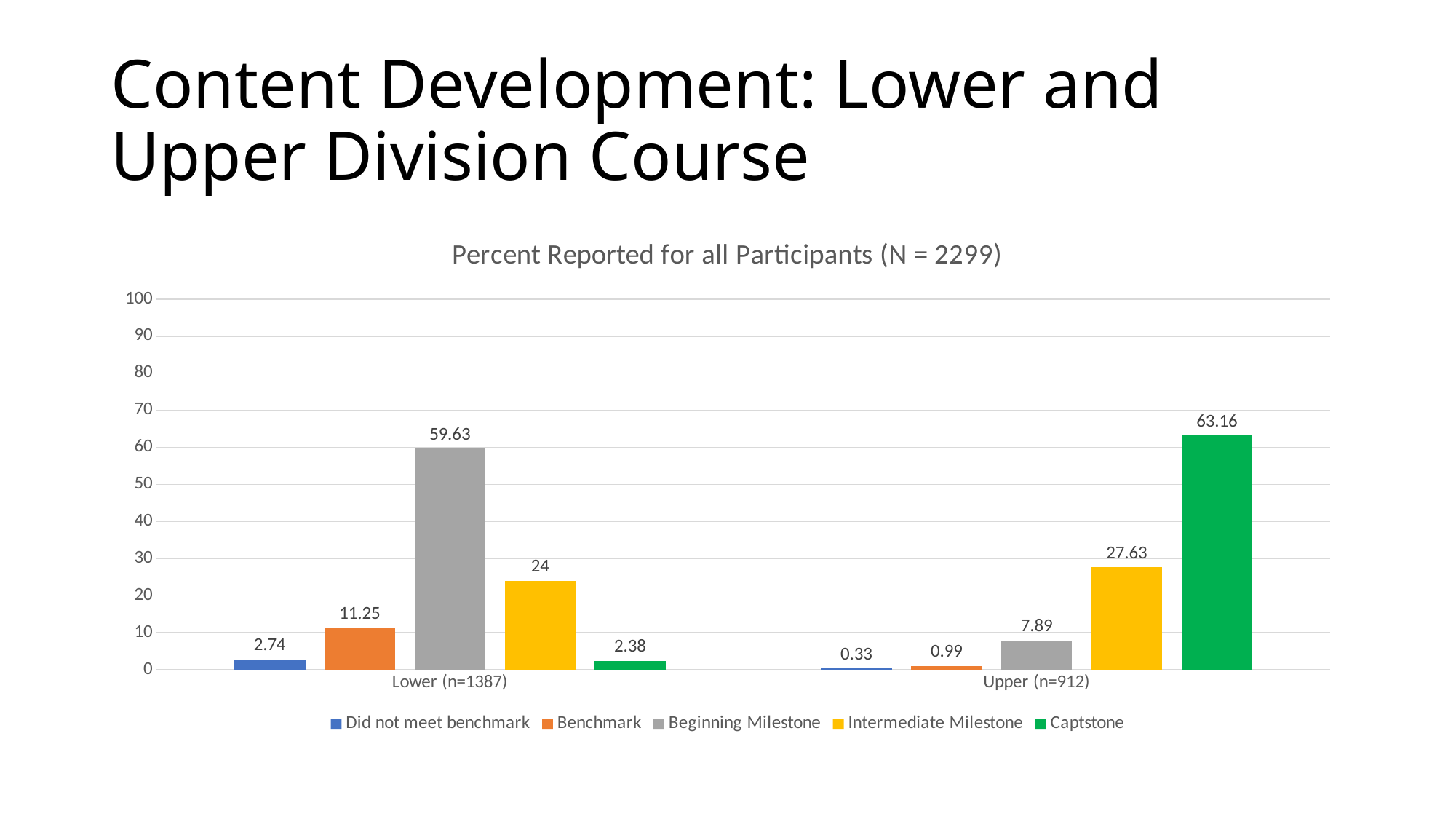
Which is larger: Benchmark for Lower (n=1387) or Beginning Milestone for Upper (n=912)? Benchmark for Lower (n=1387) What kind of chart is shown on the slide? Bar chart What is the value for Captstone in the Upper (n=912) category? 63.16 What is the value for Intermediate Milestone in the Lower (n=1387) category? 24 What is the value for Beginning Milestone in the Lower (n=1387) category? 59.63 What is the difference between the Intermediate Milestone values for Upper (n=912) and Lower (n=1387)? 3.63 What is the title of the chart? Percent Reported for all Participants (N = 2299) How many categories are shown on the x axis? 2 What is the value for Did not meet benchmark in the Upper (n=912) category? 0.33 Which series has the lowest value in the Lower (n=1387) category? Captstone Which series has the highest value in the Upper (n=912) category? Captstone How many series does the legend list? 5